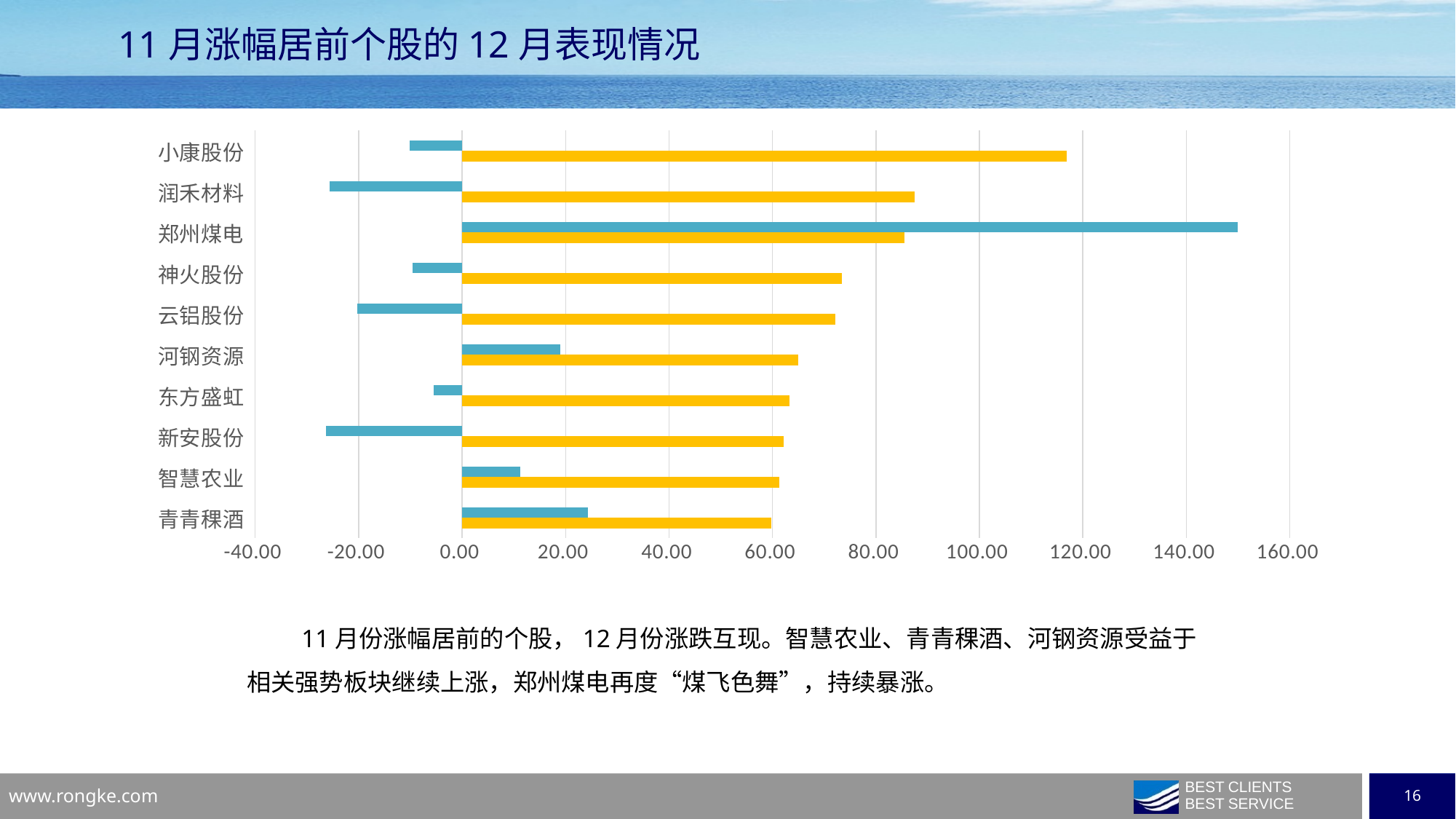
What is the title of the slide containing the chart? 11 月涨幅居前个股的 12 月表现情况 Is the blue bar value for 郑州煤电 greater or less than 140.00? greater Which stock has the longest blue bar? 郑州煤电 How many stocks (categories) are listed on the chart? 10 Which stock has the larger blue bar value, 青青稞酒 or 智慧农业? 青青稞酒 What two colours are used for the bars in the chart? blue and yellow Is the blue bar value for 润禾材料 greater or less than -20.00? less For 郑州煤电, which bar is longer, the blue one or the yellow one? the blue one What kind of chart is shown on the slide? bar chart Is the blue bar value for 河钢资源 greater or less than 0.00? greater Which stock has the longest yellow bar? 小康股份